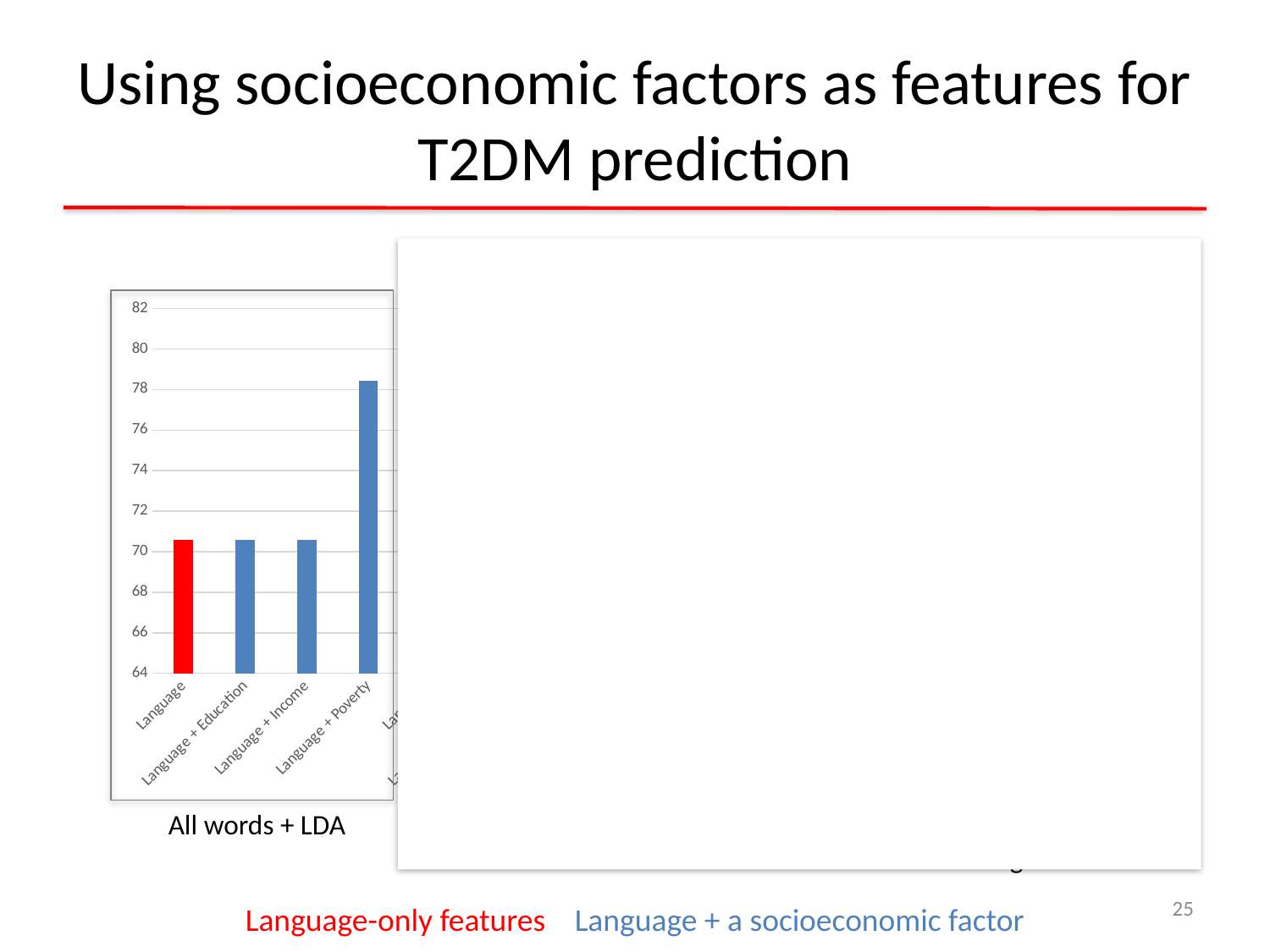
Which is larger, the value for Language + Poverty or the value for Language + Income? Language + Poverty What kind of chart is shown on the slide? bar chart Is the value for Language + Income greater or less than 74? less Is the value for Language greater or less than 72? less What colour is the bar for Language? red Among the visible bars, which category has the highest value? Language + Poverty What is the lowest value shown on the y axis? 64 Which is larger, the value for Language + Poverty or the value for Language? Language + Poverty What label appears directly below the chart? All words + LDA Is the value for Language + Poverty greater or less than 76? greater